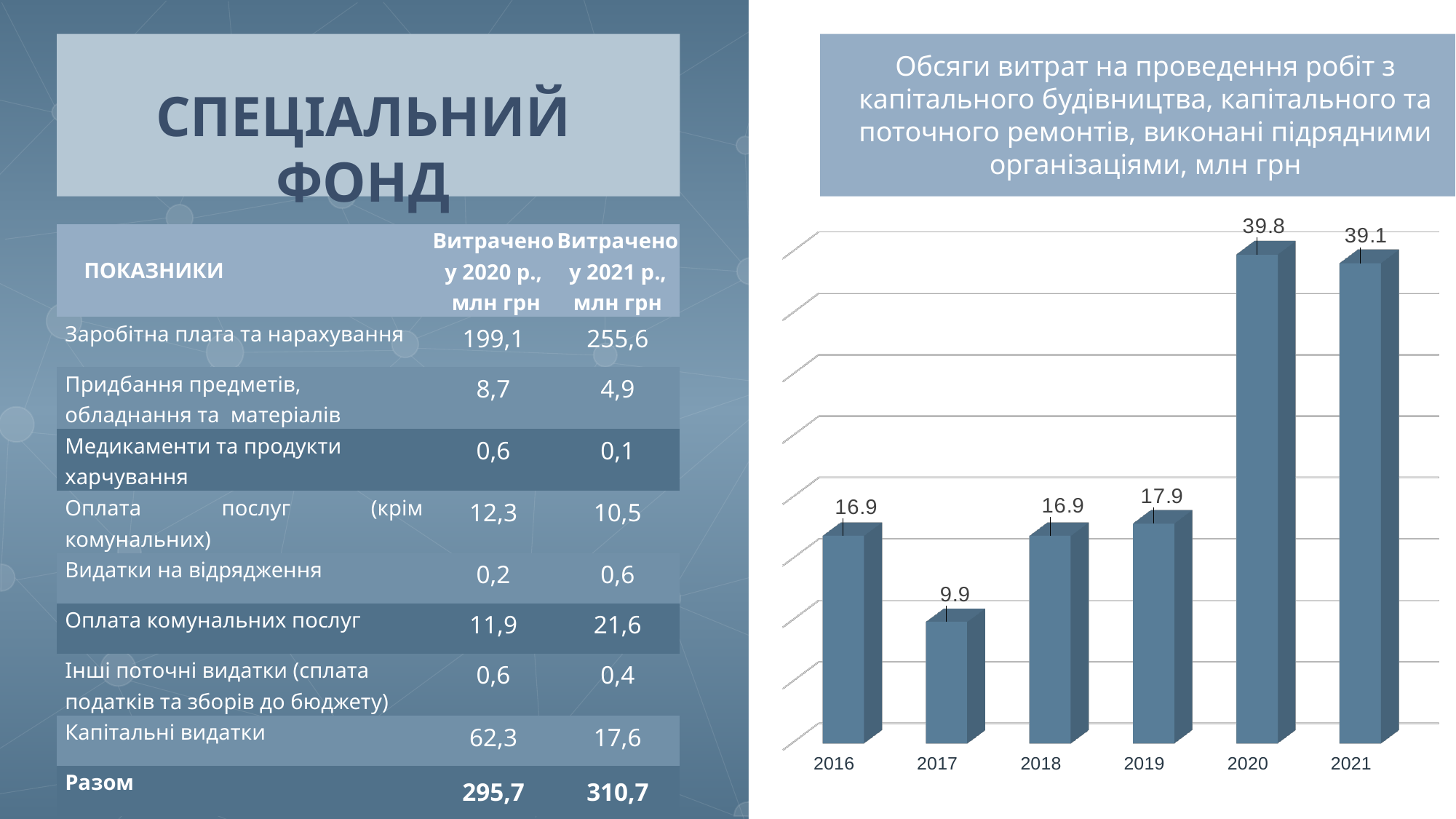
What is the difference between the values for 2018 and 2017? 7 What type of chart is shown on the slide? bar chart What is the value for 2019 in the chart? 17.9 What is the value for 2021 in the chart? 39.1 Does the value rise or fall from 2019 to 2020? rise Which year has the lowest value in the chart? 2017 What is the value for 2020 in the chart? 39.8 What is the difference between the values for 2020 and 2019? 21.9 How many years are shown on the x axis of the chart? 6 Which is larger, the value for 2016 or the value for 2017? 2016 What is the value for 2017 in the chart? 9.9 Which year has the highest value in the chart? 2020